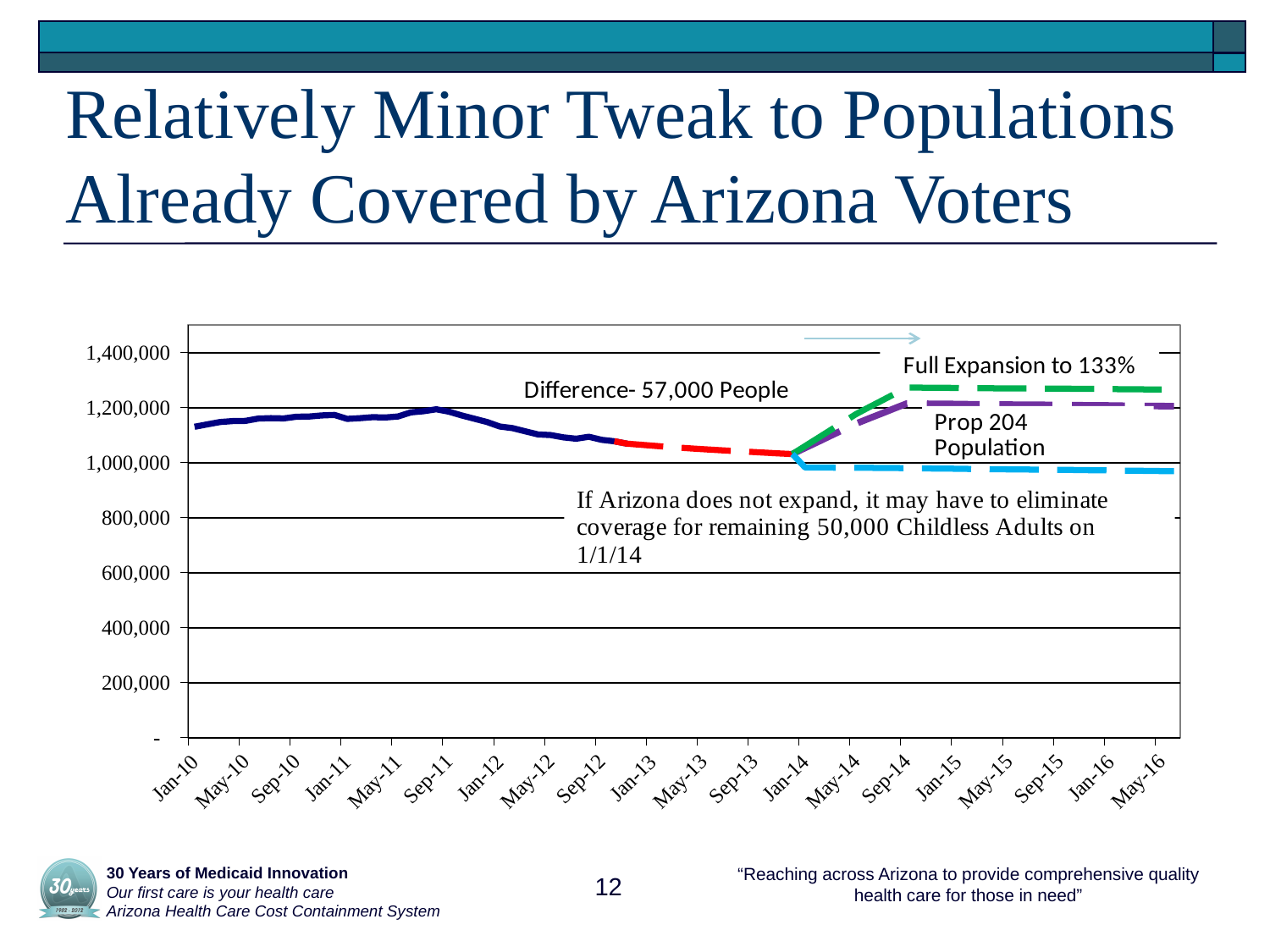
What kind of chart is shown on the slide? line chart Is the value of the purple 'Prop 204 Population' line at Jan-15 greater or less than 1,000,000? greater Does the dark blue line rise or fall between Sep-11 and Sep-12? fall Is the value of the red line at Jan-13 greater or less than 1,000,000? greater How many labels are shown along the x axis of the chart? 20 According to the chart annotation, how many Childless Adults might lose coverage on 1/1/14 if Arizona does not expand? 50,000 Is the value of the light blue line at May-16 greater or less than 1,000,000? less According to the annotation on the chart, what is the difference in people between the expansion scenarios? 57,000 People At Jan-15, which line is higher: the green 'Full Expansion to 133%' line or the purple 'Prop 204 Population' line? Full Expansion to 133% At which x-axis label does the dark blue line reach its highest point? Sep-11